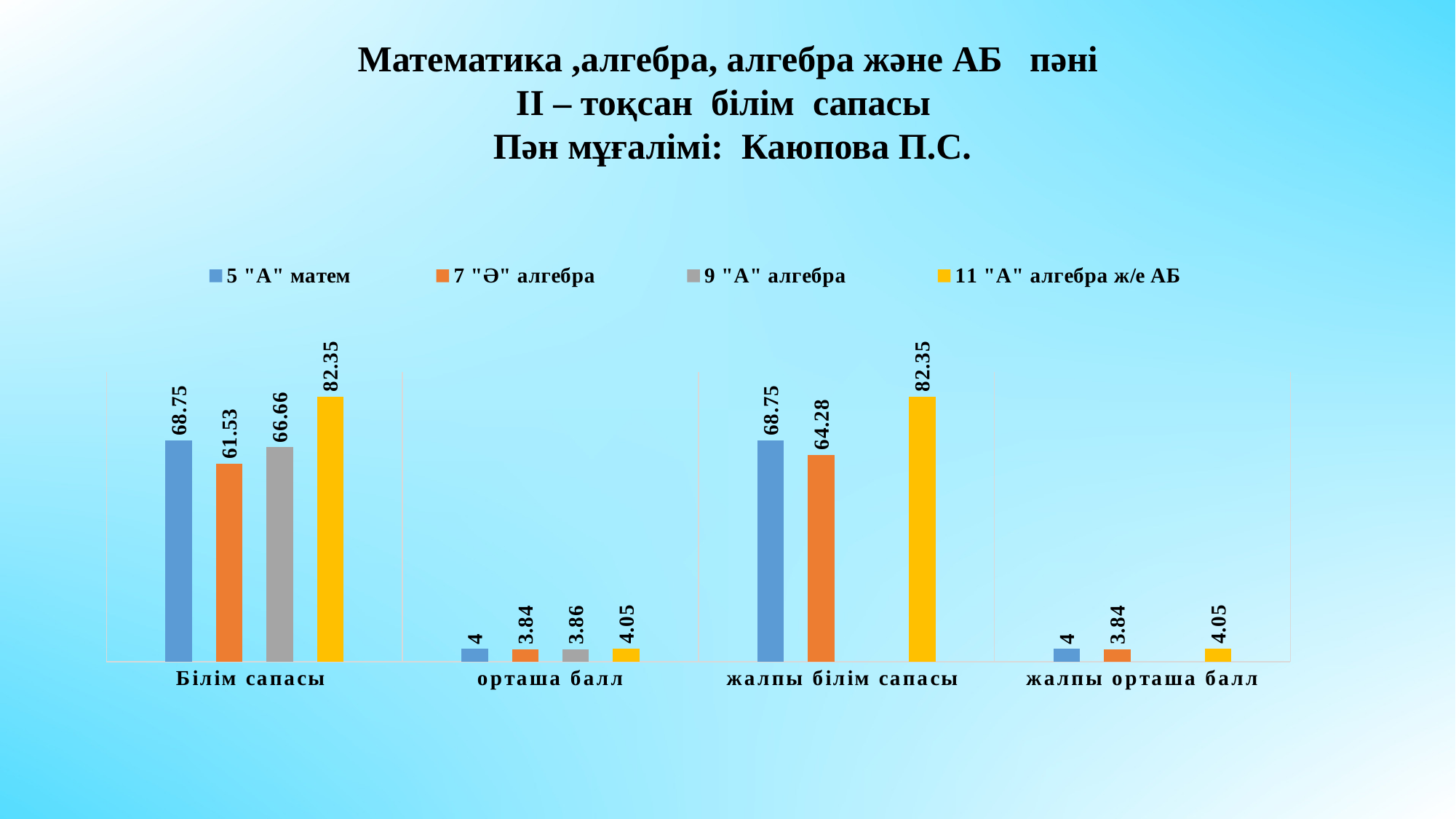
How many categories are shown on the x axis? 4 What is the difference between the 11 "А" алгебра ж/е АБ and 5 "А" матем values in the Білім сапасы category? 13.6 What is the value for 9 "А" алгебра in the орташа балл category? 3.86 Which series has the highest value in the Білім сапасы category? 11 "А" алгебра ж/е АБ What is the value for 7 "Ә" алгебра in the жалпы білім сапасы category? 64.28 What is the value for 7 "Ә" алгебра in the Білім сапасы category? 61.53 Which series is shown in yellow in the legend? 11 "А" алгебра ж/е АБ In the Білім сапасы category, which is larger: the value for 5 "А" матем or the value for 9 "А" алгебра? 5 "А" матем What is the value for 11 "А" алгебра ж/е АБ in the Білім сапасы category? 82.35 How many series does the legend list? 4 What kind of chart is shown on the slide? bar chart Which series has the lowest value in the орташа балл category? 7 "Ә" алгебра